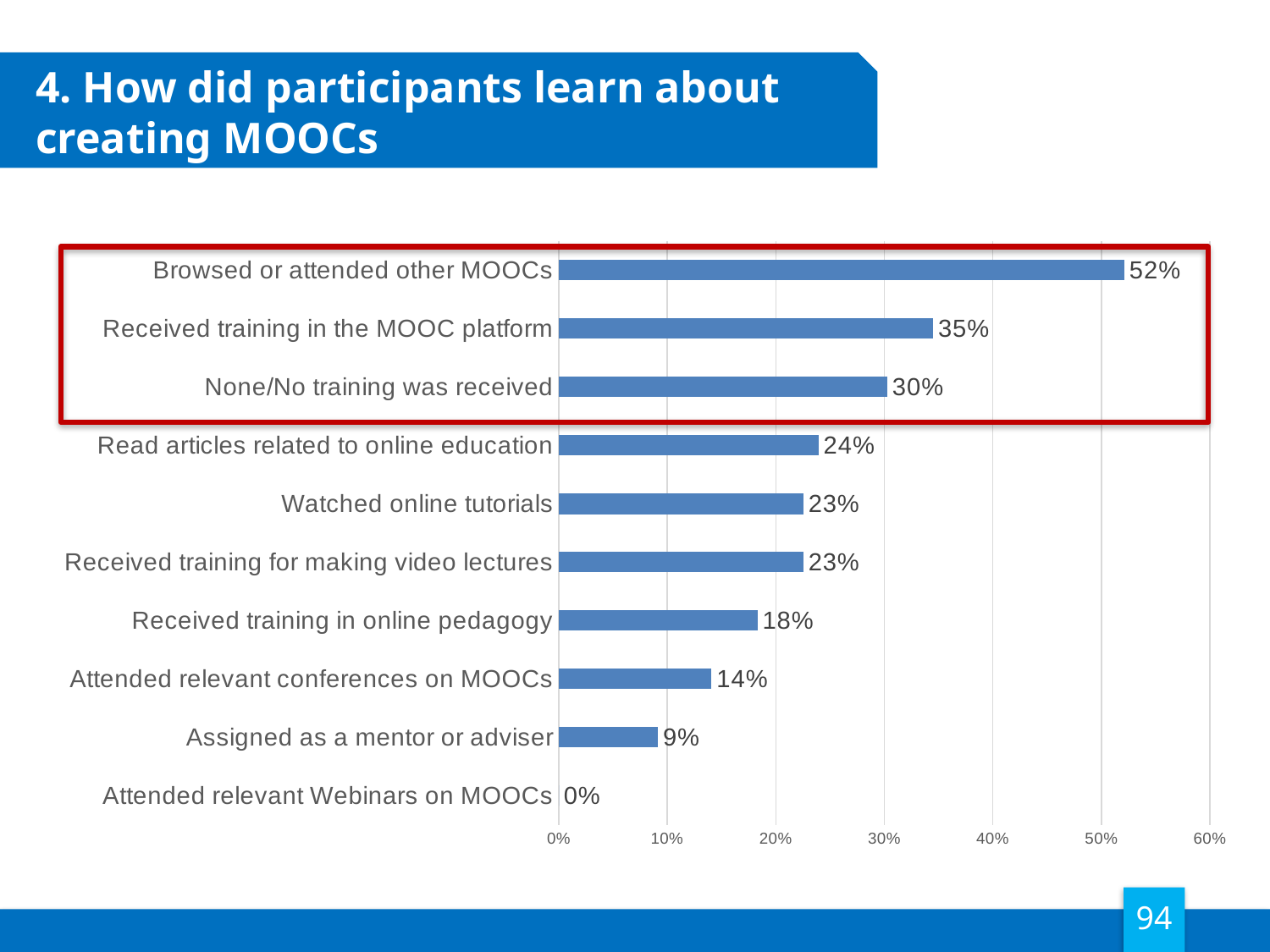
Is the value for 'Browsed or attended other MOOCs' greater or less than 50%? greater How many categories are shown in the chart? 10 What kind of chart is shown on the slide? Bar chart What is the difference between the highest and lowest values in the chart? 52% How many categories are enclosed by the red box on the chart? 3 What is the value for 'Assigned as a mentor or adviser'? 9% Which is larger: 'Read articles related to online education' or 'Attended relevant conferences on MOOCs'? Read articles related to online education What is the difference between 'Received training in the MOOC platform' and 'None/No training was received'? 5% Which category has the highest value? Browsed or attended other MOOCs Which category has the lowest value? Attended relevant Webinars on MOOCs What percentage of participants browsed or attended other MOOCs? 52% What is the value for 'Received training in online pedagogy'? 18%